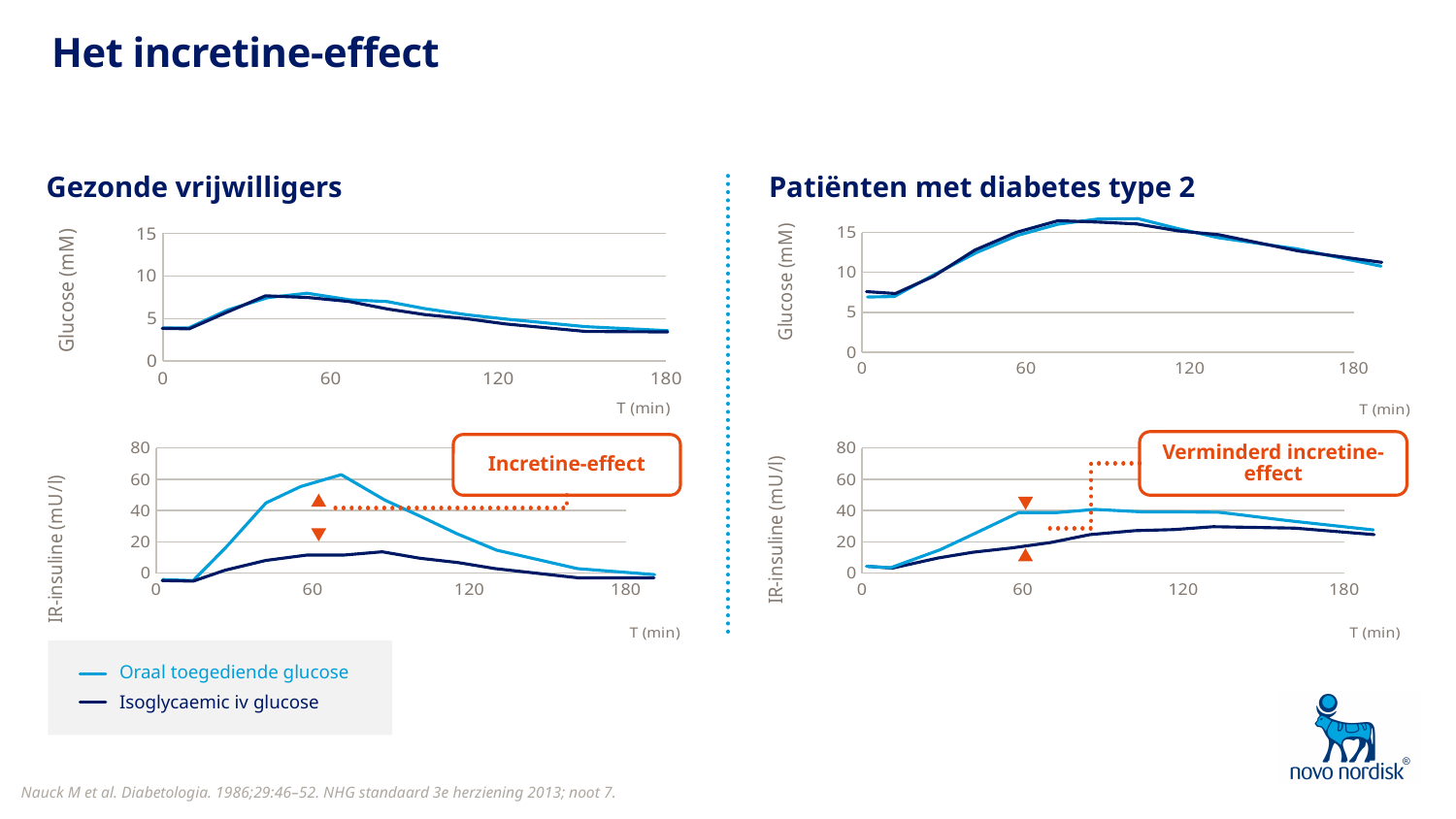
In the 'IR-insuline (mU/l)' chart under 'Gezonde vrijwilligers', which series has the higher value at 60 minutes: 'Oraal toegediende glucose' or 'Isoglycaemic iv glucose'? Oraal toegediende glucose In the 'Glucose (mM)' chart under 'Gezonde vrijwilligers', is the peak glucose value greater or less than 10? less In the 'IR-insuline (mU/l)' chart under 'Gezonde vrijwilligers', do the 'Oraal toegediende glucose' values rise or fall between 0 and 60 minutes? rise What text is in the orange box on the 'IR-insuline (mU/l)' chart under 'Patiënten met diabetes type 2'? Verminderd incretine-effect In the 'Glucose (mM)' chart under 'Gezonde vrijwilligers', do the glucose values rise or fall between 60 and 180 minutes? fall In the 'IR-insuline (mU/l)' chart under 'Gezonde vrijwilligers', is the peak value of the 'Oraal toegediende glucose' line greater or less than 40? greater In the 'IR-insuline (mU/l)' chart under 'Gezonde vrijwilligers', is the peak value of the 'Isoglycaemic iv glucose' line greater or less than 20? less What is the label on the x axis of the charts on this slide? T (min) What kind of chart is the 'Glucose (mM)' chart under 'Gezonde vrijwilligers'? line chart How many series does the legend at the bottom left of the slide list? 2